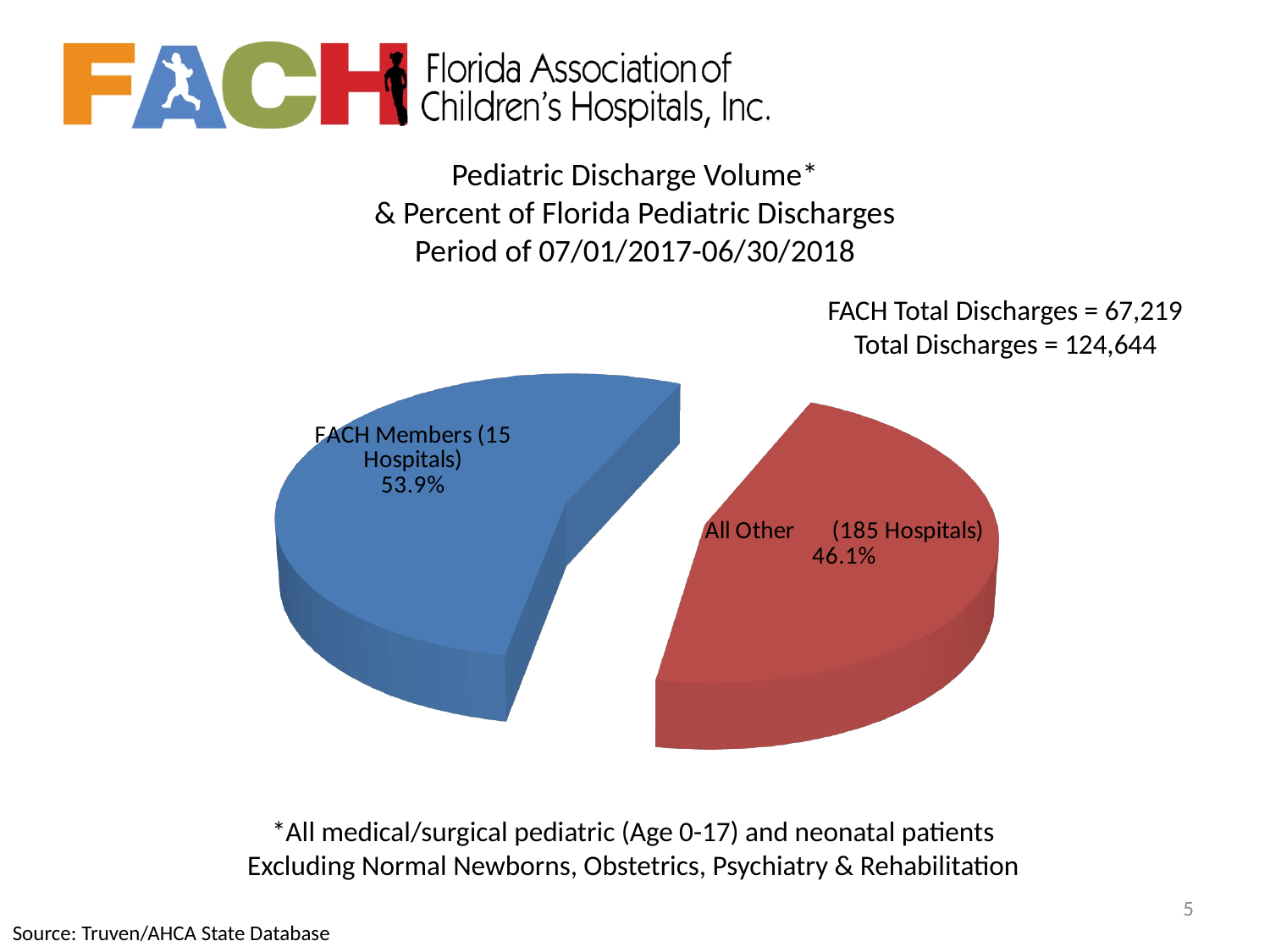
What percentage of Florida pediatric discharges is attributed to All Other (185 Hospitals)? 46.1% What colour is the slice for All Other (185 Hospitals)? Red What is the FACH Total Discharges figure shown on the slide? 67,219 How many slices does the pie chart have? 2 Which slice of the pie chart is the largest? FACH Members (15 Hospitals) Which slice of the pie chart is the smallest? All Other (185 Hospitals) What percentage of Florida pediatric discharges is attributed to FACH Members (15 Hospitals)? 53.9% What kind of chart is shown on the slide? Pie chart What is the Total Discharges figure shown on the slide? 124,644 What is the difference in percentage points between the FACH Members slice and the All Other slice? 7.8 Is the share for FACH Members (15 Hospitals) greater or less than 50%? greater Which slice is larger, FACH Members (15 Hospitals) or All Other (185 Hospitals)? FACH Members (15 Hospitals)